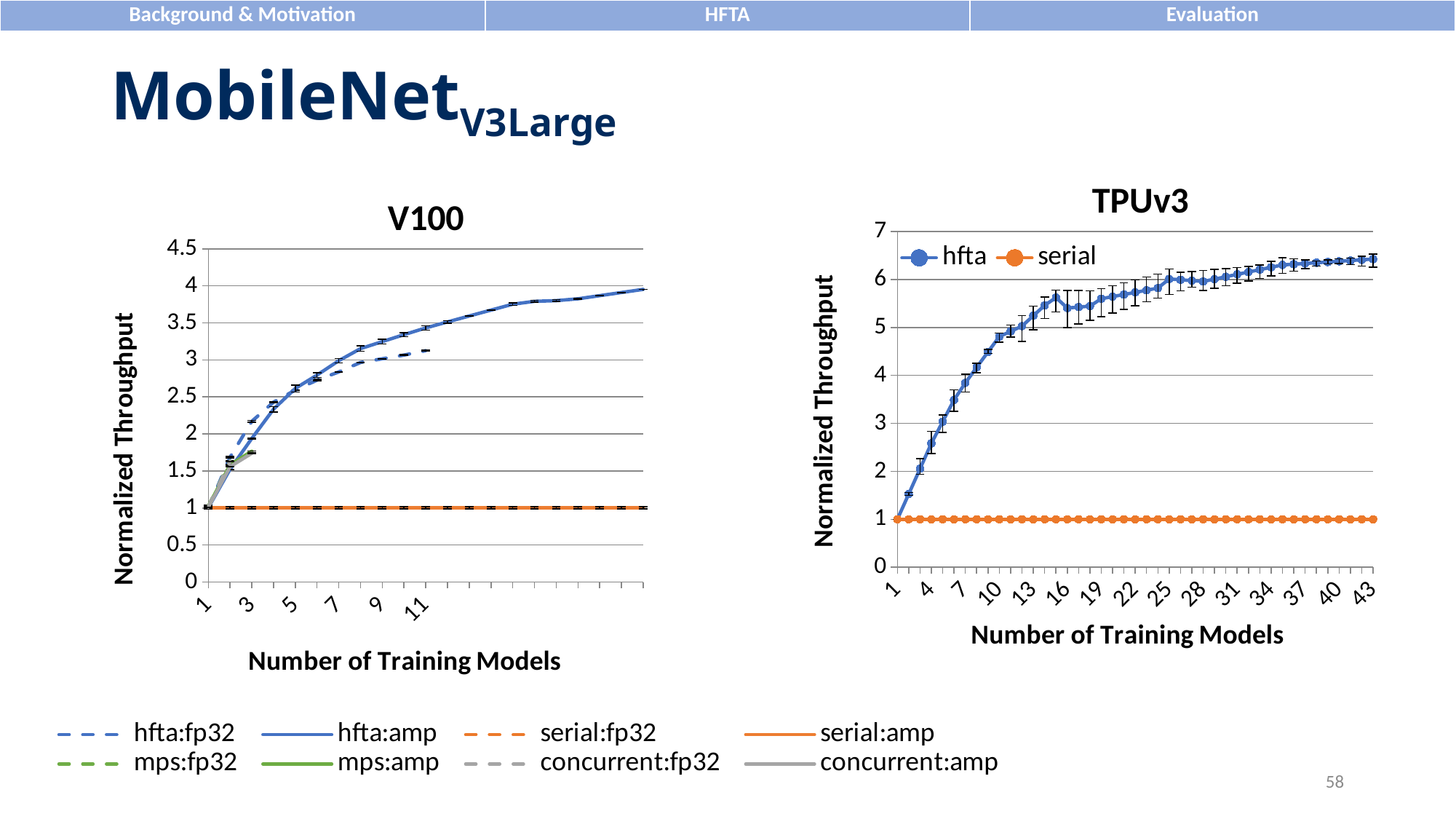
How many series does the legend below the V100 chart list? 8 In the TPUv3 chart, is the hfta value at 10 training models greater or less than 4? greater In the V100 chart, is the hfta:amp value at 11 training models greater or less than 3? greater What is the y-axis label of the V100 chart? Normalized Throughput In the TPUv3 chart, is the hfta value at 43 training models greater or less than 6? greater How many series does the legend of the TPUv3 chart list? 2 What kind of chart is the TPUv3 chart? line chart In the TPUv3 chart, what is the normalized throughput of the serial series? 1 In the TPUv3 chart, which series is higher at 43 training models, hfta or serial? hfta What kind of chart is the V100 chart? line chart In the TPUv3 chart, does the hfta series rise or fall as the number of training models increases? rise